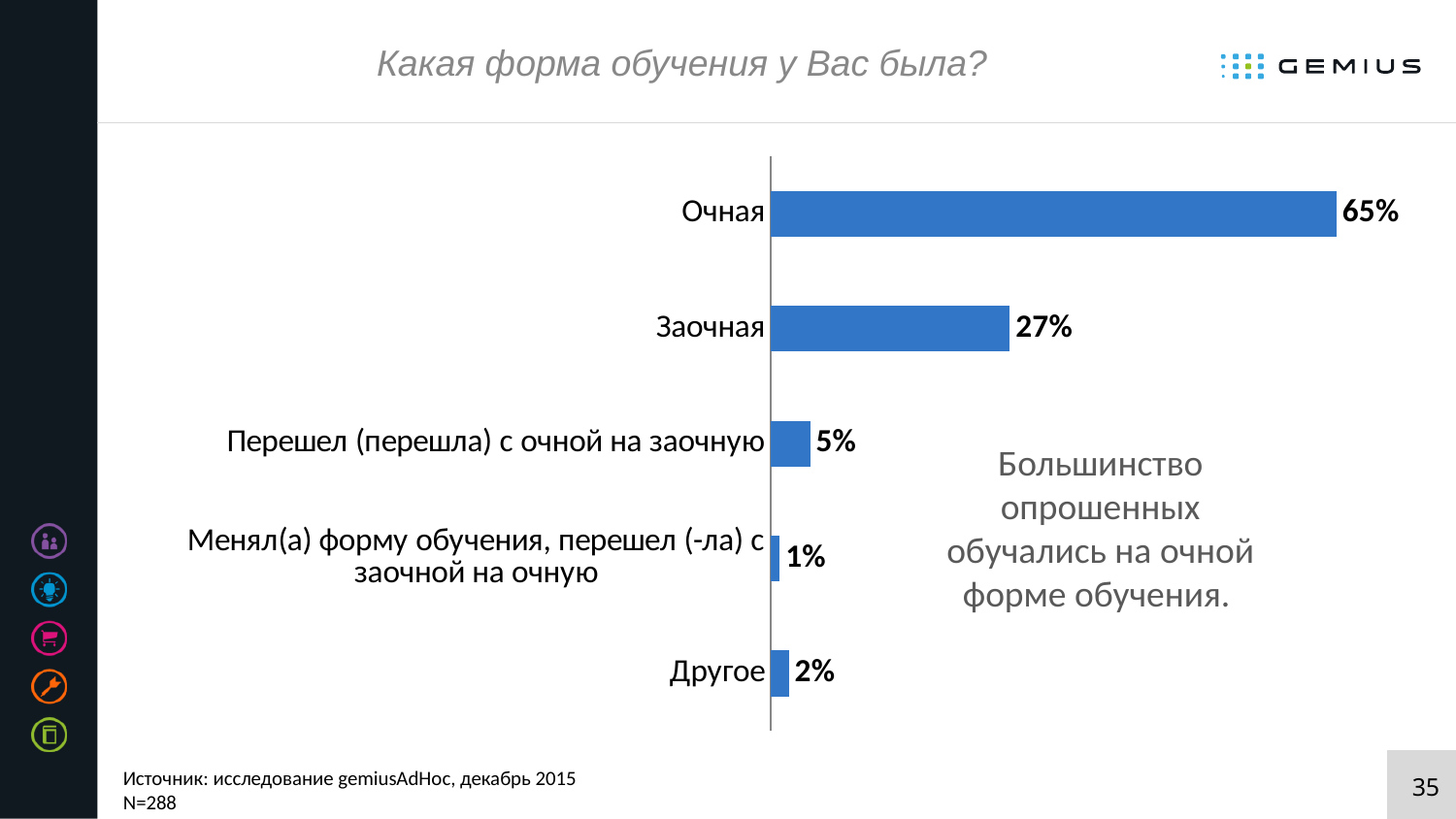
What is the difference between the values for Очная and Заочная? 38% What kind of chart is shown on the slide? Bar chart What is the value for Другое? 2% Which category has the highest value? Очная What is the title of the chart on the slide? Какая форма обучения у Вас была? Which is larger, the value for Другое or the value for Перешел (перешла) с очной на заочную? Перешел (перешла) с очной на заочную What is the value for Заочная? 27% What is the value for Очная? 65% How many categories are shown in the chart? 5 Which category has the lowest value? Менял(а) форму обучения, перешел (-ла) с заочной на очную What is the value for Перешел (перешла) с очной на заочную? 5% What is the value for Менял(а) форму обучения, перешел (-ла) с заочной на очную? 1%